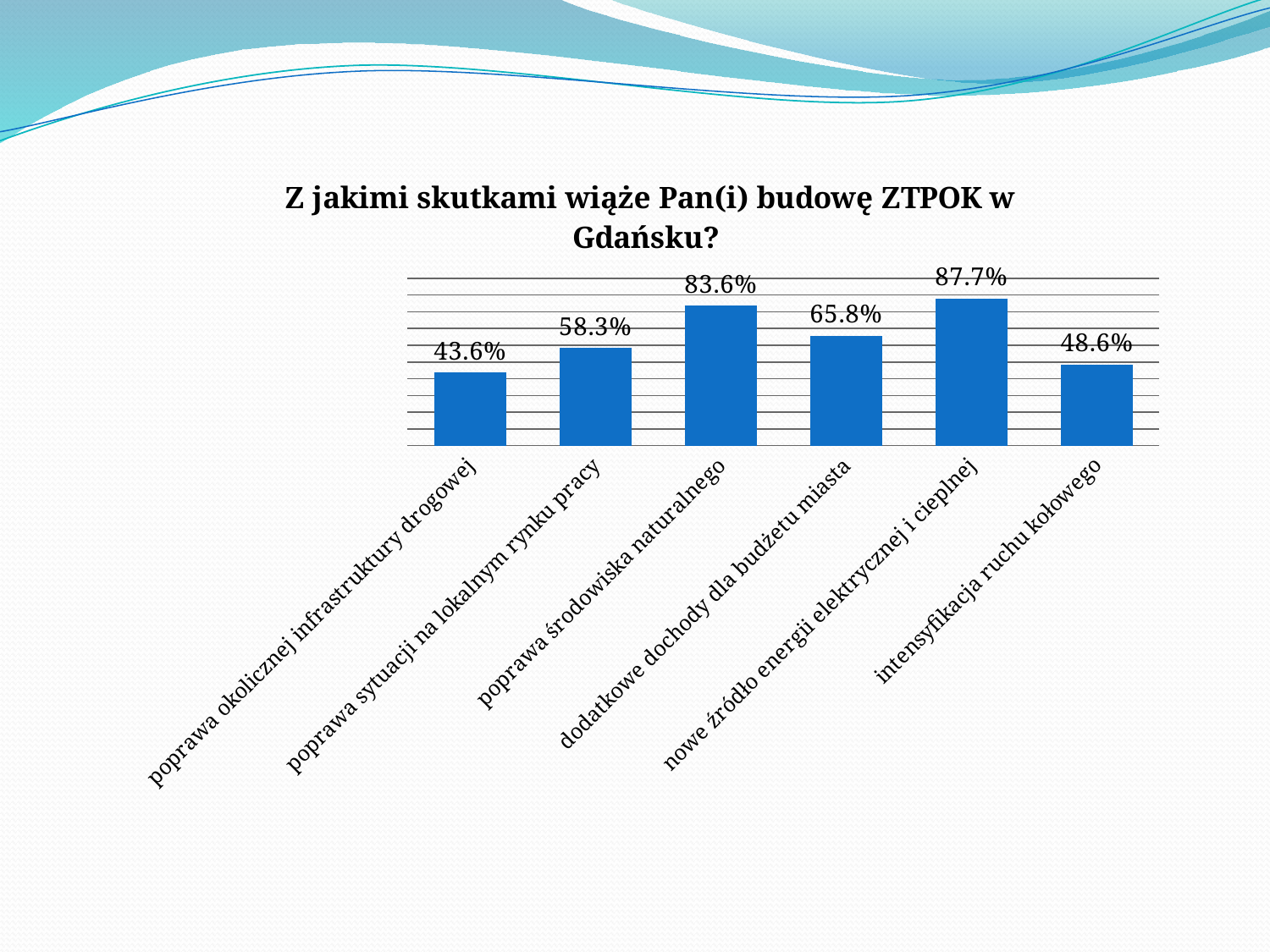
What is the value for "intensyfikacja ruchu kołowego"? 48.6% What is the value for "poprawa środowiska naturalnego"? 83.6% Which category has the highest value? nowe źródło energii elektrycznej i cieplnej What is the difference between the values for "nowe źródło energii elektrycznej i cieplnej" and "poprawa środowiska naturalnego"? 4.1% What is the value for "dodatkowe dochody dla budżetu miasta"? 65.8% How many categories are shown in the chart? 6 Which category has the lowest value? poprawa okolicznej infrastruktury drogowej What is the title of the chart? Z jakimi skutkami wiąże Pan(i) budowę ZTPOK w Gdańsku? What kind of chart is shown on the slide? bar chart What is the difference between the values for "dodatkowe dochody dla budżetu miasta" and "poprawa sytuacji na lokalnym rynku pracy"? 7.5% What is the value for "poprawa okolicznej infrastruktury drogowej"? 43.6% Which is larger: the value for "intensyfikacja ruchu kołowego" or the value for "poprawa sytuacji na lokalnym rynku pracy"? poprawa sytuacji na lokalnym rynku pracy